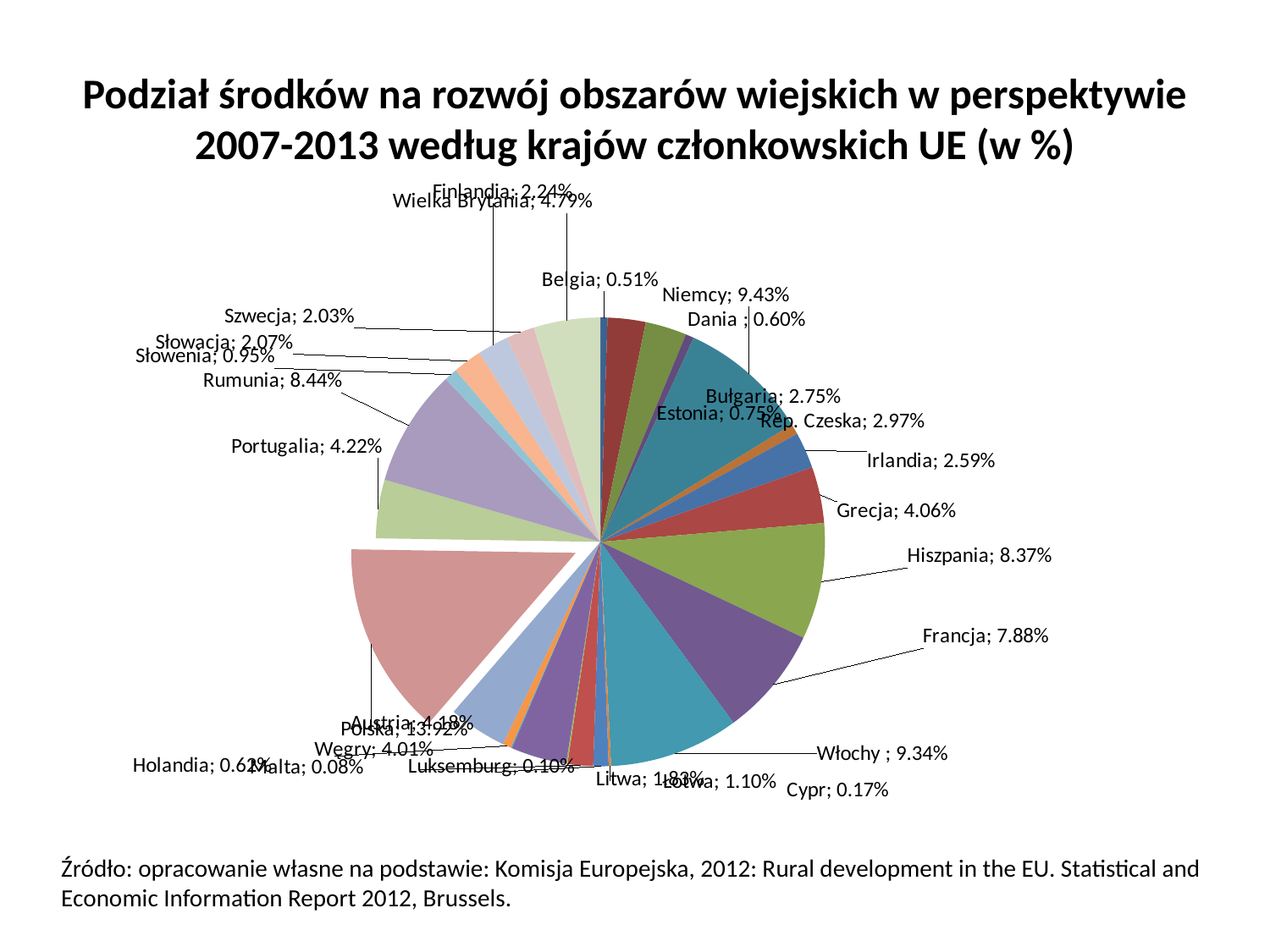
What type of chart is shown on the slide? Pie chart Which has a larger share, Francja or Włochy? Włochy What is the value for Cypr? 0.17% Which has a larger share, Grecja or Portugalia? Portugalia What share is shown for Wielka Brytania? 4.79% What is the value labelled for Luksemburg? 0.10% What share does Niemcy have in the pie chart? 9.43% What is the value shown for Hiszpania? 8.37% What is the difference between the shares of Hiszpania and Francja? 0.49% What percentage is labelled for Rumunia? 8.44% What is the difference between the shares of Niemcy and Włochy? 0.09% What period is referred to in the chart title? 2007-2013